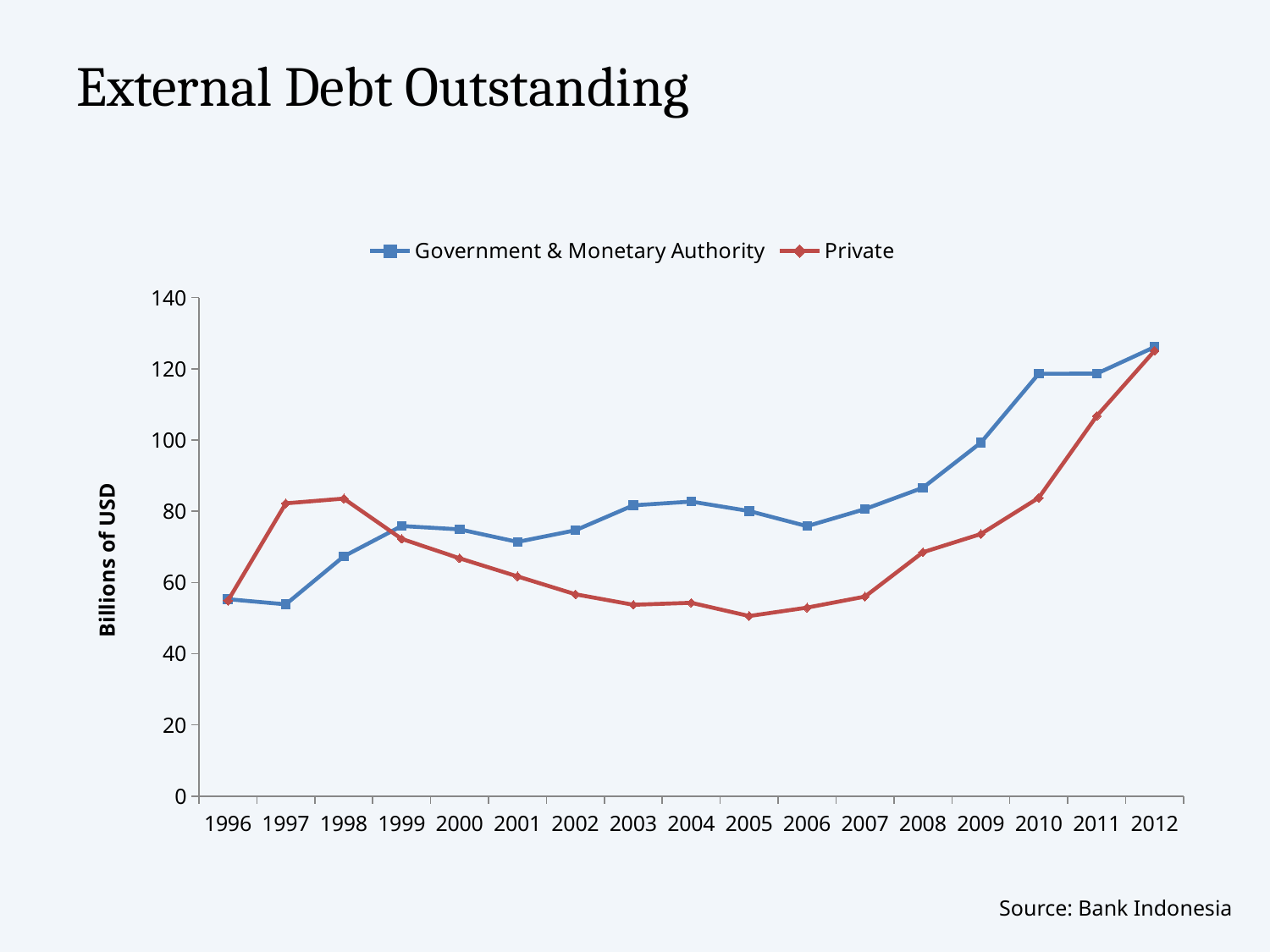
What is the title of the y axis? Billions of USD What kind of chart is shown on the slide? line chart In which year is the Private series at its lowest? 2005 In 2006, which series has the larger value, Government & Monetary Authority or Private? Government & Monetary Authority How many series does the legend list? 2 Does the Private series rise or fall from 2007 to 2012? rise In which year is the Government & Monetary Authority series at its highest? 2012 Is the value for Government & Monetary Authority in 2010 greater or less than 100? greater Is the value for Private in 2005 greater or less than 60? less How many years are plotted along the x axis? 17 Is the value for Private in 1998 greater or less than 80? greater In 1997, which series has the larger value, Government & Monetary Authority or Private? Private